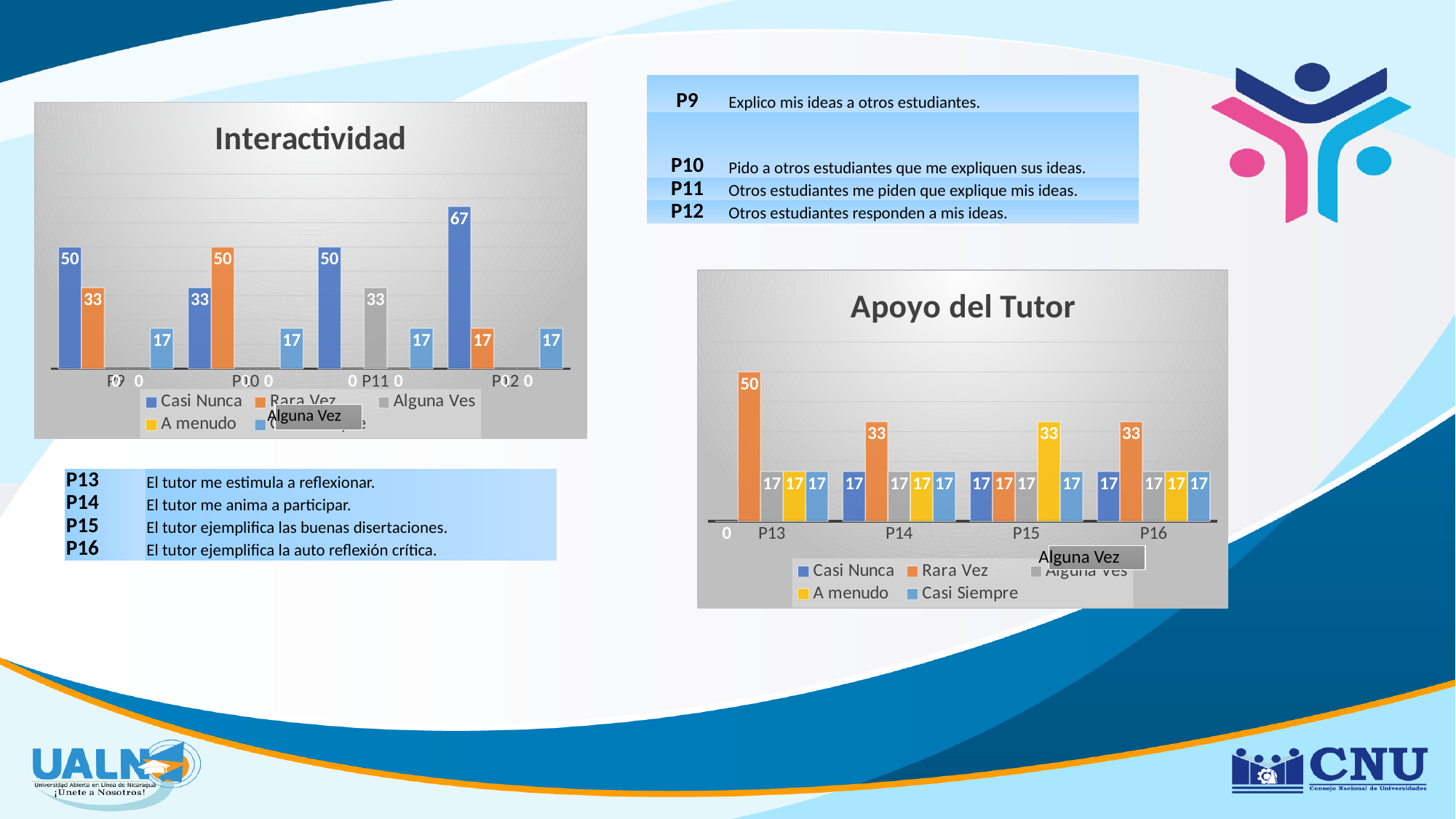
In the Interactividad chart, how many categories are shown on the x axis? 4 In the Apoyo del Tutor chart, which category has the highest Rara Vez value? P13 How many series does the legend of the Apoyo del Tutor chart list? 5 In the Interactividad chart, which category has the highest Casi Nunca value? P12 In the Interactividad chart, what is the difference between the Casi Nunca and Rara Vez values for P9? 17 In the Apoyo del Tutor chart, what is the value of Rara Vez for P13? 50 In the Apoyo del Tutor chart, is the Rara Vez value for P14 larger or smaller than the Rara Vez value for P15? larger What type of chart is the Apoyo del Tutor chart? bar chart In the Apoyo del Tutor chart, what is the value of A menudo for P15? 33 In the Interactividad chart, what is the value of Rara Vez for P10? 50 In the Interactividad chart, what is the value of Alguna Ves for P11? 33 In the Interactividad chart, what is the value of Casi Nunca for P12? 67